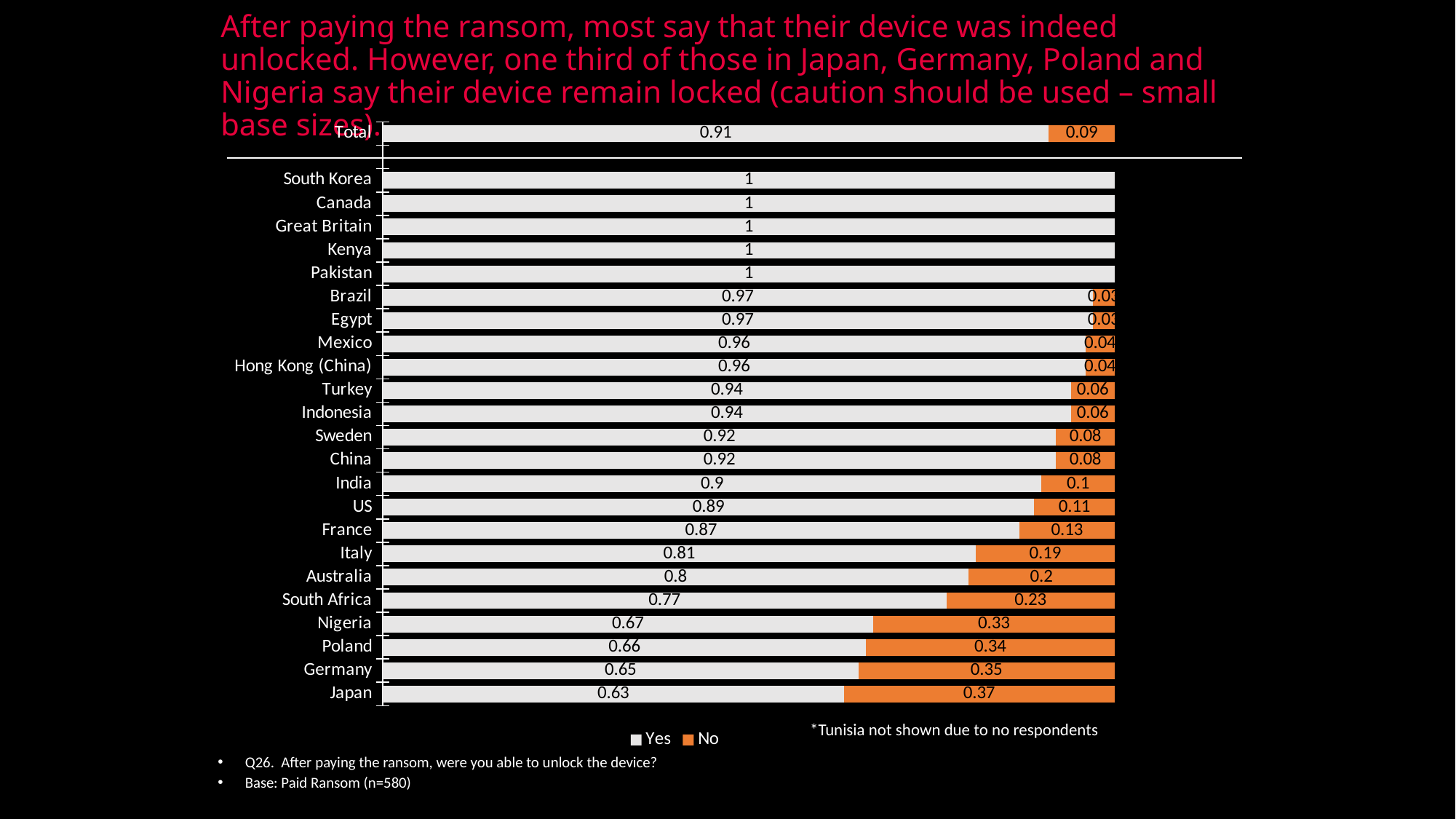
What is the "Yes" value for the Total row? 0.91 What kind of chart is shown on the slide? Stacked bar chart What is the difference between the "No" values for Germany and Italy? 0.16 Which has a larger "Yes" value, South Africa or Australia? Australia Which colour represents the "No" series in the legend? Orange What is the "No" value for Nigeria? 0.33 Which country has the highest "No" value? Japan What is the "No" value for France? 0.13 How many series does the legend list? 2 How many countries are listed on the chart, excluding the Total row? 23 Which country has the lowest "Yes" value? Japan What is the "Yes" value for Japan? 0.63